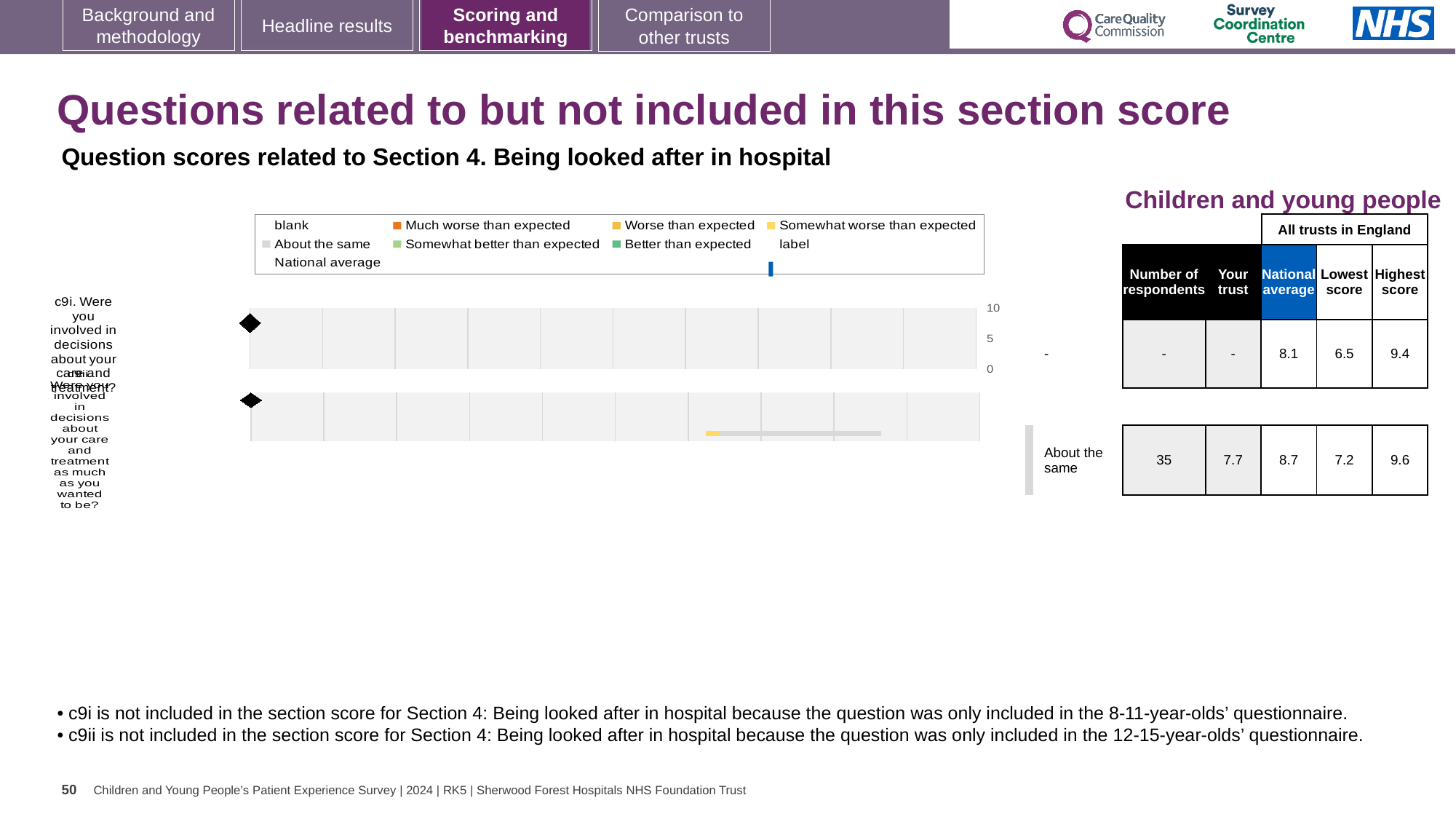
How many entries does the chart legend list? 9 Is the end of the bar for c9ii greater or less than 5 on the chart axis? greater How many question categories are plotted on the chart? 2 What is the highest tick value shown on the chart's axis? 10 Which of the two plotted questions, c9i or c9ii, shows a visible coloured bar on the chart? c9ii What colour is used for the 'Better than expected' legend entry? green What kind of chart is shown on the slide? bar chart